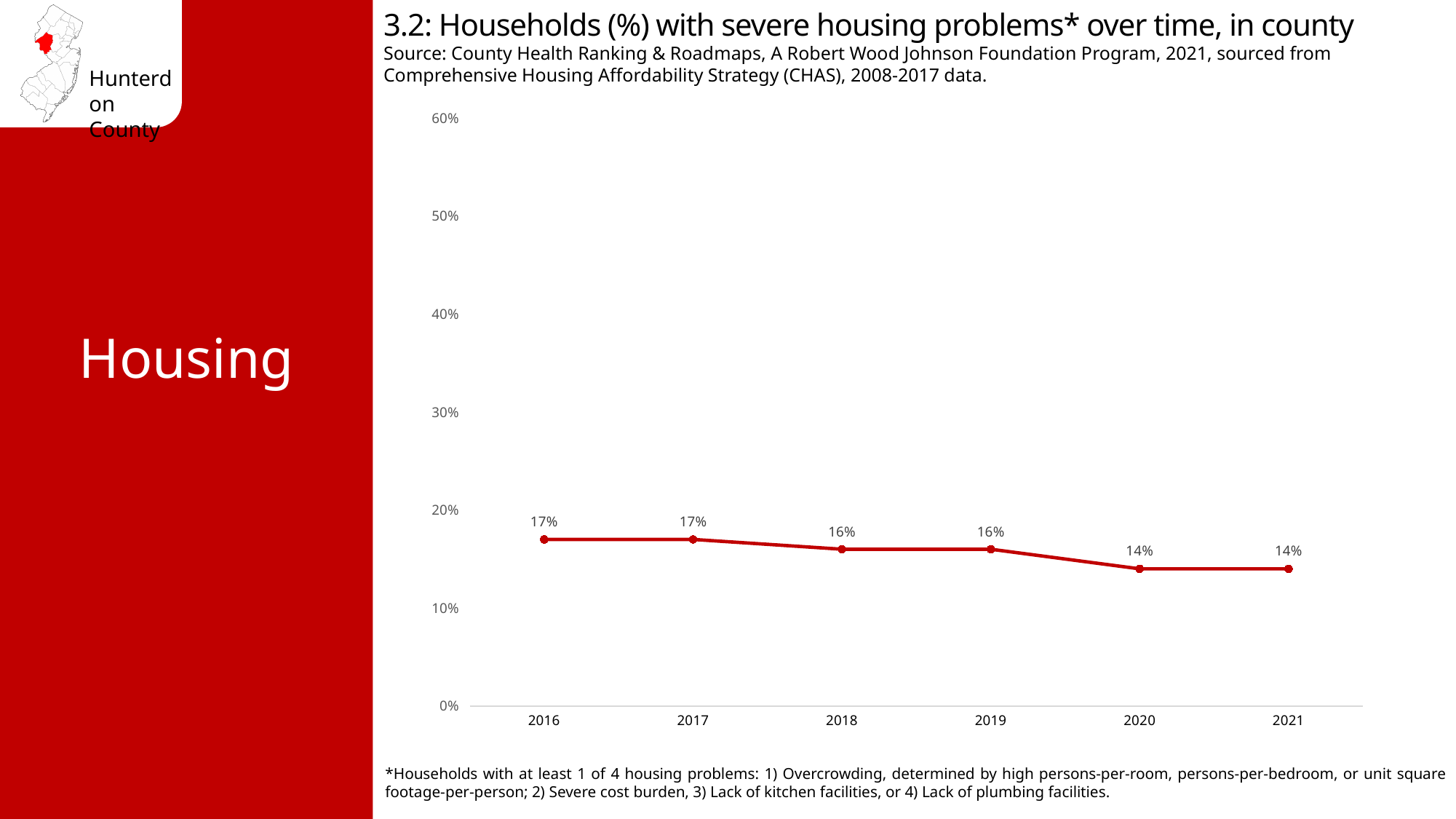
Do the values rise or fall from 2016 to 2021? fall What kind of chart is shown on the slide? line chart What is the value shown for 2020? 14% Is the value for 2016 greater or less than 20%? less How many years are plotted on the chart? 6 What percentage of households had severe housing problems in 2016? 17% What percentage of households had severe housing problems in 2021? 14% What is the difference between the 2016 value and the 2021 value? 3% Which year has the lowest value on the chart (give the earliest if tied)? 2020 What is the value shown for 2018? 16% Is the value for 2017 larger or smaller than the value for 2019? larger What is the title of the chart? 3.2: Households (%) with severe housing problems* over time, in county